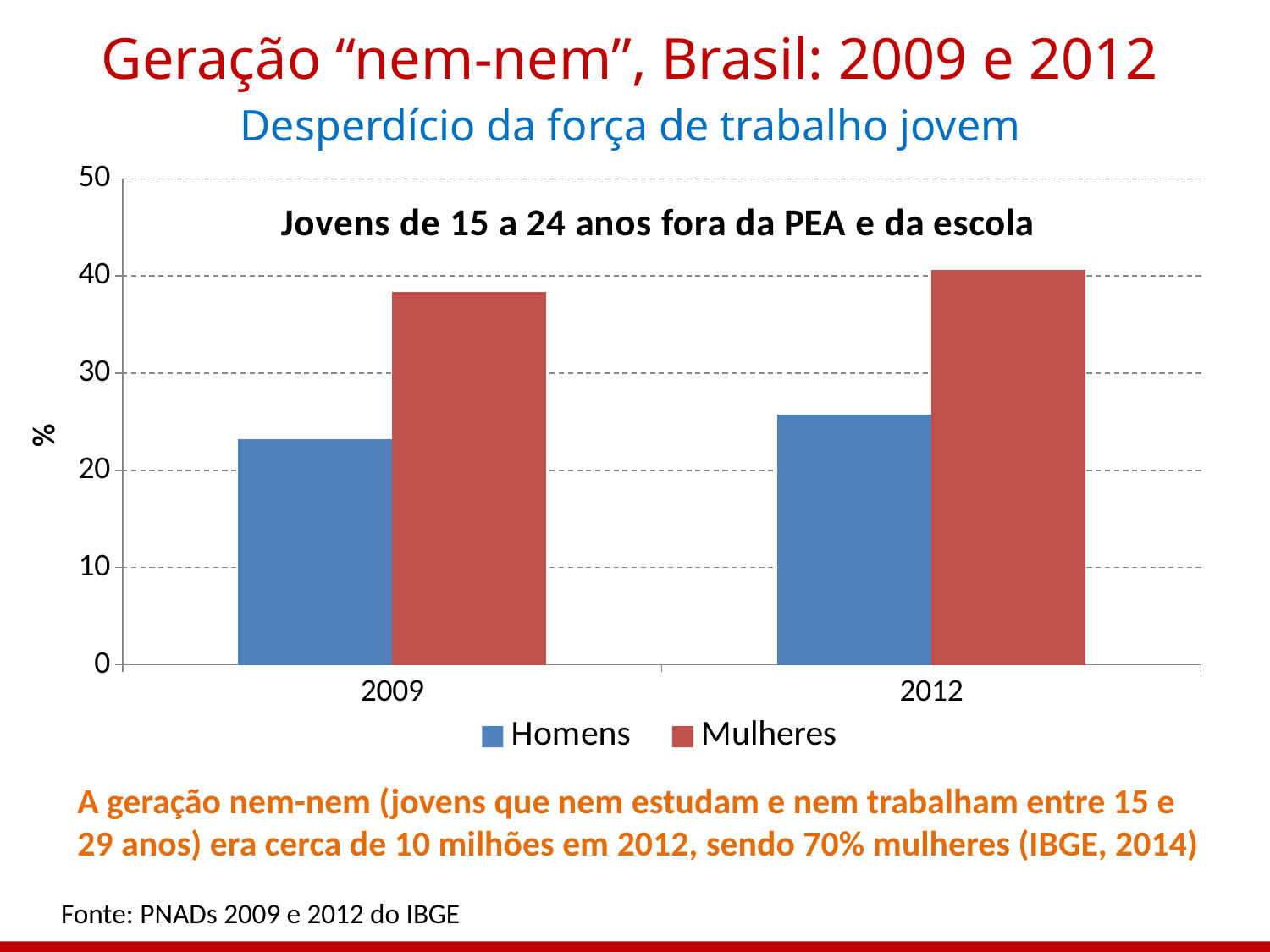
Is the value for Mulheres in 2012 greater or less than 30? greater How many series does the legend list? 2 In 2012, which is larger, the value for Homens or for Mulheres? Mulheres What is the title of the chart? Jovens de 15 a 24 anos fora da PEA e da escola What kind of chart is shown on the slide? bar chart Which series and year has the highest bar? Mulheres, 2012 Is the value for Homens in 2012 greater or less than 30? less How many year categories are shown on the x axis? 2 Which series and year has the lowest bar? Homens, 2009 Is the value for Homens in 2009 greater or less than 20? greater Does the value for Homens rise or fall from 2009 to 2012? rise